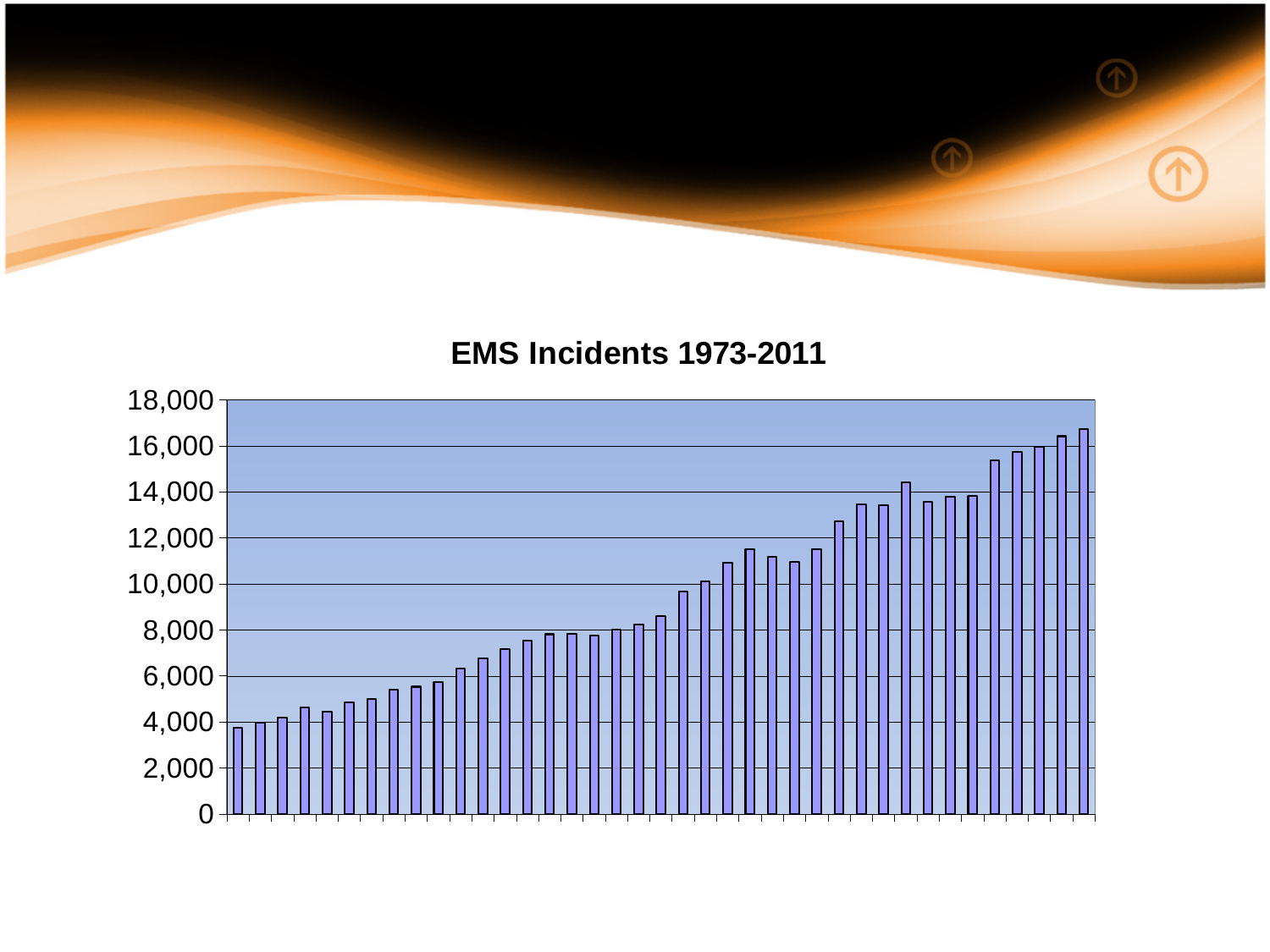
Do the values generally rise or fall from left to right across the chart? rise Is the value of the rightmost bar greater or less than 16,000? greater Does any bar reach 18,000? no What is the title of the chart? EMS Incidents 1973-2011 Is the value of the leftmost bar greater or less than 2,000? greater Which bar is the highest in the chart? the rightmost bar Which is larger, the leftmost bar or the rightmost bar? the rightmost bar What kind of chart is shown on the slide? bar chart How many bars are plotted in the chart? 39 What is the highest value shown on the vertical axis? 18,000